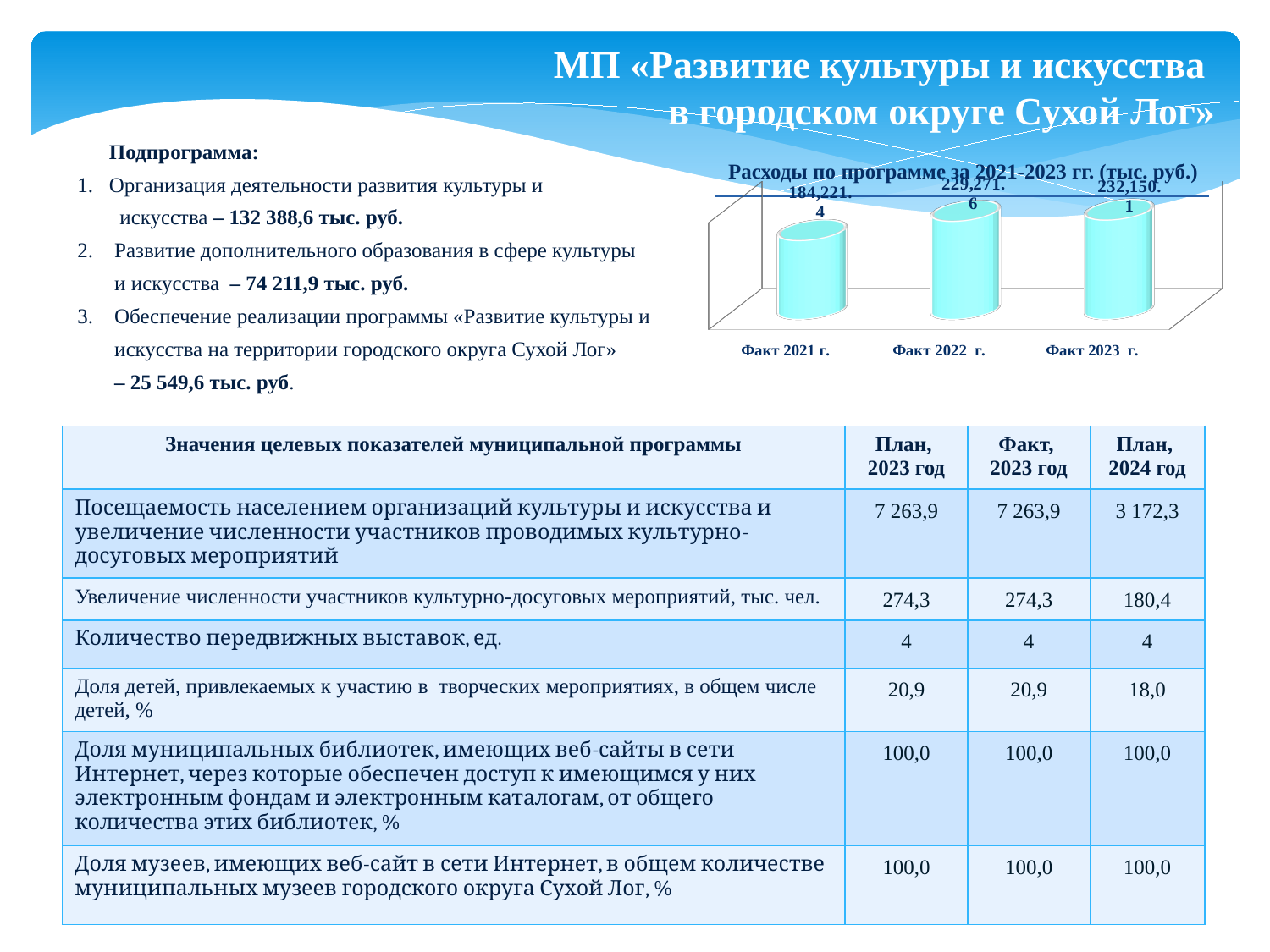
What is the value for Факт 2022 г. in the chart «Расходы по программе за 2021-2023 гг.»? 229,271.6 Which year has the lowest expenditure in the chart «Расходы по программе за 2021-2023 гг.»? Факт 2021 г. What is the difference between the values for Факт 2022 г. and Факт 2021 г. in the chart «Расходы по программе за 2021-2023 гг.»? 45,050.2 Do the values in the chart «Расходы по программе за 2021-2023 гг.» rise or fall from 2021 to 2023? Rise What is the value for Факт 2023 г. in the chart «Расходы по программе за 2021-2023 гг.»? 232,150.1 In what units are the values of the chart «Расходы по программе за 2021-2023 гг.» given, according to its title? тыс. руб. Which year has the highest expenditure in the chart «Расходы по программе за 2021-2023 гг.»? Факт 2023 г. What is the difference between the values for Факт 2023 г. and Факт 2021 г. in the chart «Расходы по программе за 2021-2023 гг.»? 47,928.7 What kind of chart is «Расходы по программе за 2021-2023 гг.»? Bar chart What is the value for Факт 2021 г. in the chart «Расходы по программе за 2021-2023 гг.»? 184,221.4 In the chart «Расходы по программе за 2021-2023 гг.», which is larger: the value for Факт 2021 г. or Факт 2022 г.? Факт 2022 г. How many bars are shown in the chart «Расходы по программе за 2021-2023 гг.»? 3